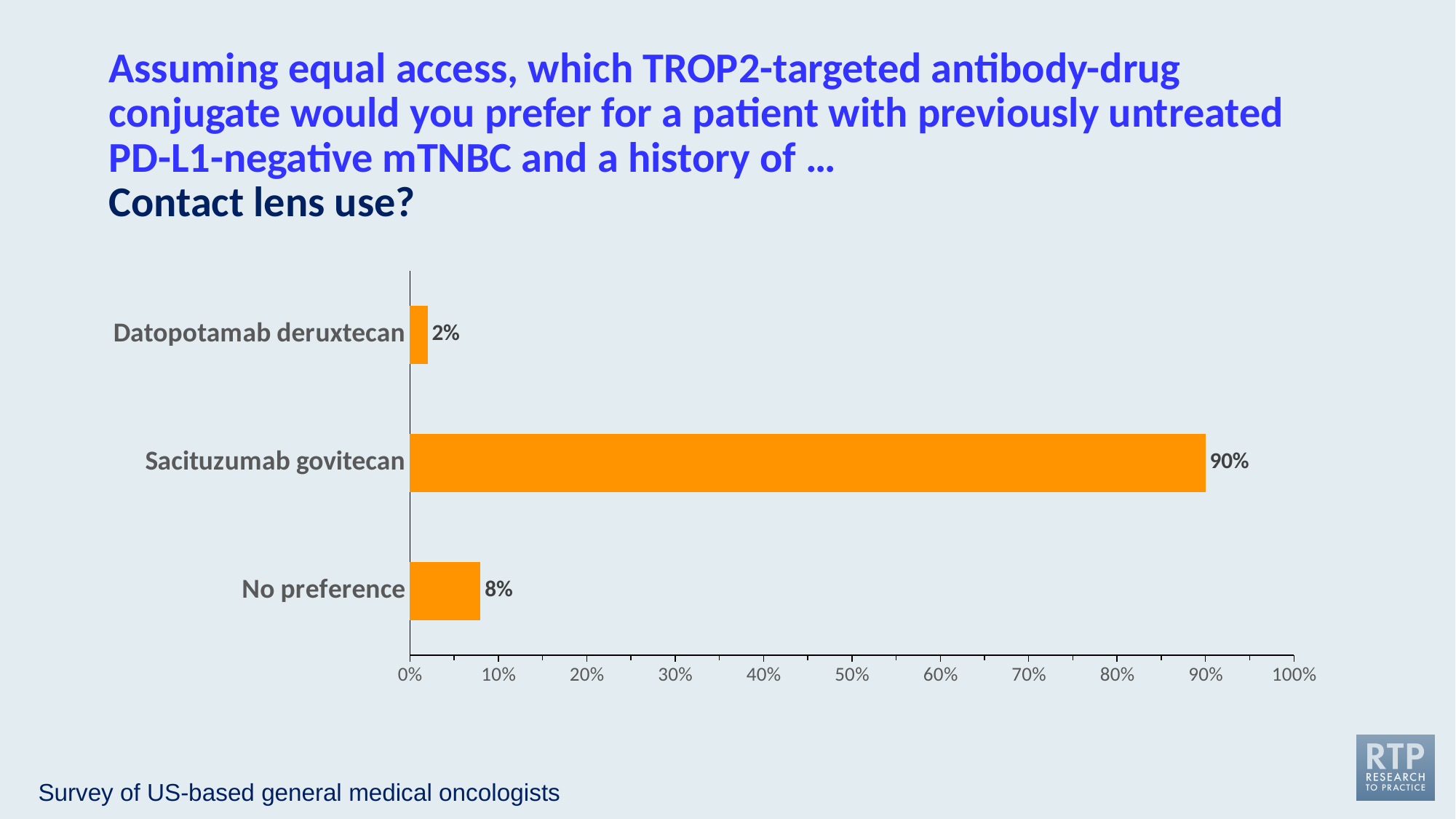
Which option received the highest percentage of responses? Sacituzumab govitecan Is the value for sacituzumab govitecan greater or less than 80%? greater What is the difference in percentage points between no preference and datopotamab deruxtecan? 6 What percentage of respondents preferred sacituzumab govitecan? 90% How many response categories are shown in the chart? 3 What type of chart is shown on the slide? Bar chart Which option received the lowest percentage of responses? Datopotamab deruxtecan What is the difference in percentage points between sacituzumab govitecan and no preference? 82 Which received a larger share of responses, datopotamab deruxtecan or no preference? No preference What percentage of respondents had no preference? 8% What percentage of respondents preferred datopotamab deruxtecan? 2% What is the maximum value shown on the x axis of the chart? 100%